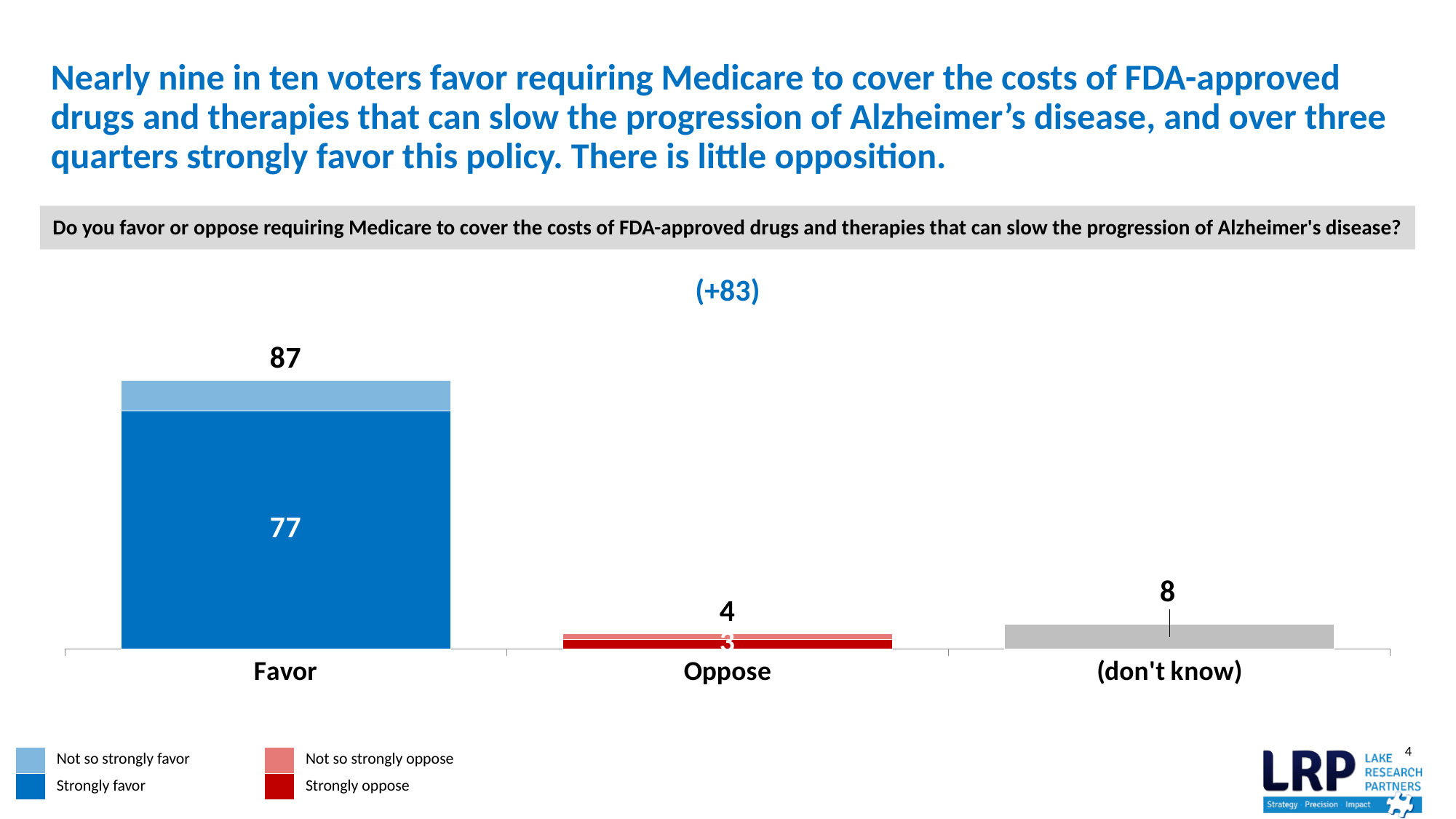
What is the total value shown for the Favor bar? 87 Which category has the lowest total value? Oppose What is the value for Strongly favor? 77 What is the difference between the Favor total and the Oppose total? 83 What is the total value shown for the Oppose bar? 4 What kind of chart is shown on the slide? Stacked bar chart Which category has the highest total value? Favor What is the difference between the Favor total and the Strongly favor value? 10 What is the value for Strongly oppose? 3 Which is larger, the value for (don't know) or the total for Oppose? (don't know) How many categories are shown on the x axis? 3 What is the value for (don't know)? 8